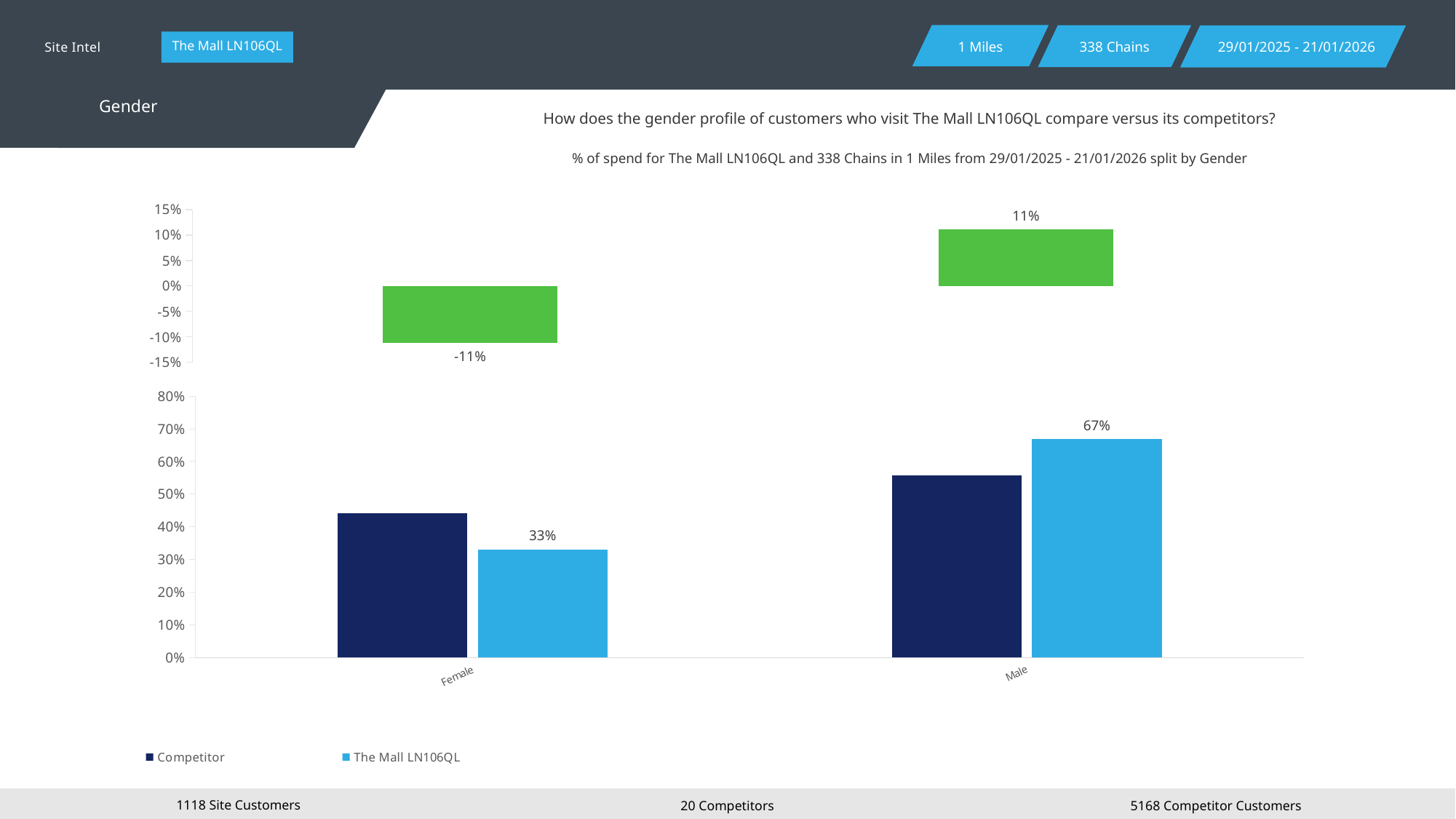
In the bottom chart, what is the value for The Mall LN106QL for Male? 67% How many series does the legend of the bottom chart list? 2 In the top chart, what is the value shown for Female? -11% In the bottom chart, which gender has the higher value for The Mall LN106QL? Male In the bottom chart, for Male, which is larger: Competitor or The Mall LN106QL? The Mall LN106QL In the bottom chart, for Female, which is larger: Competitor or The Mall LN106QL? Competitor In the bottom chart, is the Competitor value for Male greater or less than 60%? less In the top chart, what is the value shown for Male? 11% In the bottom chart, what is the difference between The Mall LN106QL's Male and Female values? 34% In the bottom chart, is the Competitor value for Female greater or less than 40%? greater In the bottom chart, what is the value for The Mall LN106QL for Female? 33% What type of chart is the bottom chart? Bar chart